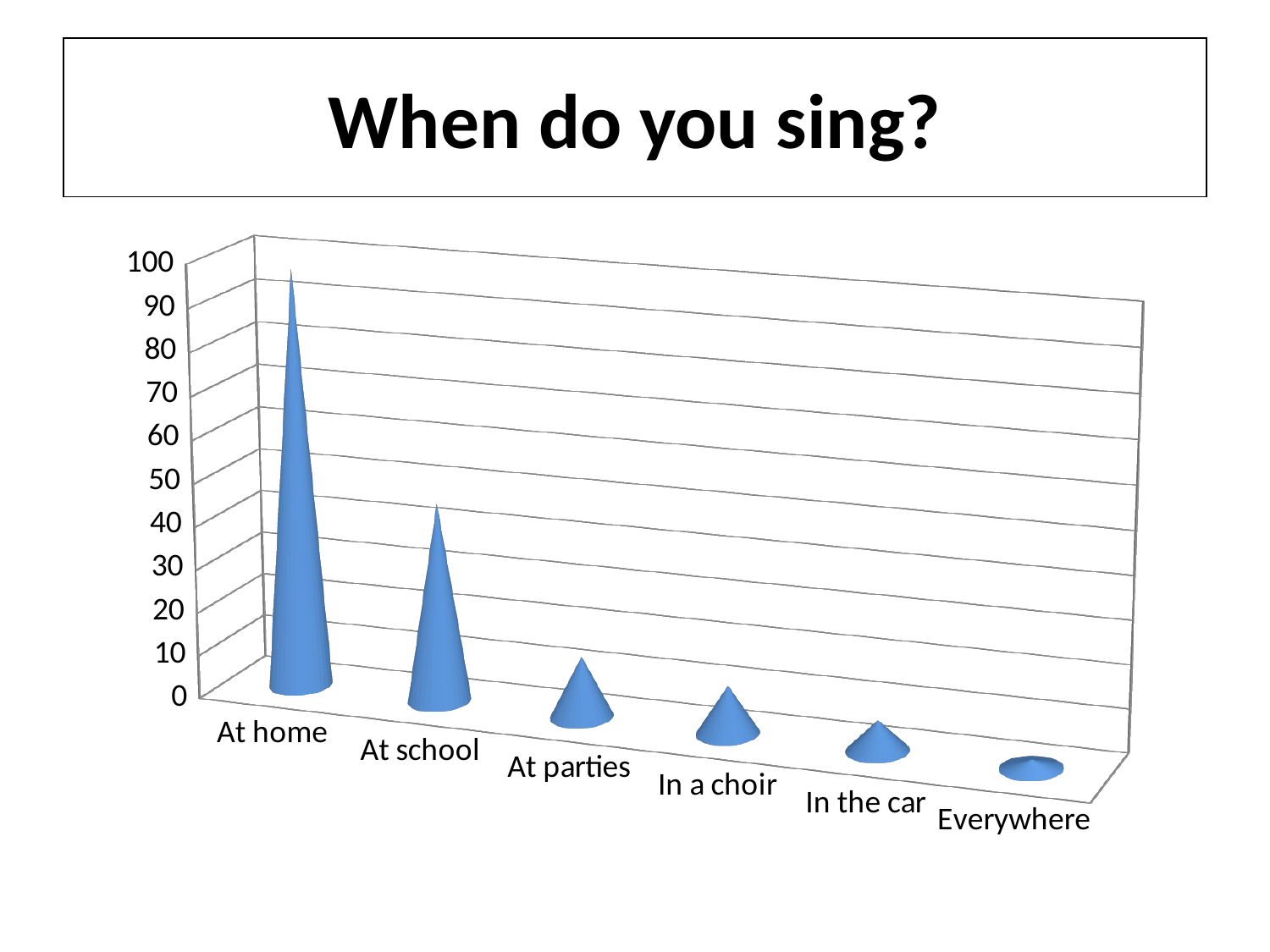
What kind of chart is shown on the slide? bar chart Do the values rise or fall moving from left to right along the x axis? fall Which is larger, the value for At home or the value for At school? At home What is the title of the chart? When do you sing? Is the value for At home greater or less than 50? greater Which category has the lowest value? Everywhere Is the value for Everywhere greater or less than 10? less Which category has the highest value? At home Is the value for At school greater or less than 50? less How many categories are shown on the x axis of the chart? 6